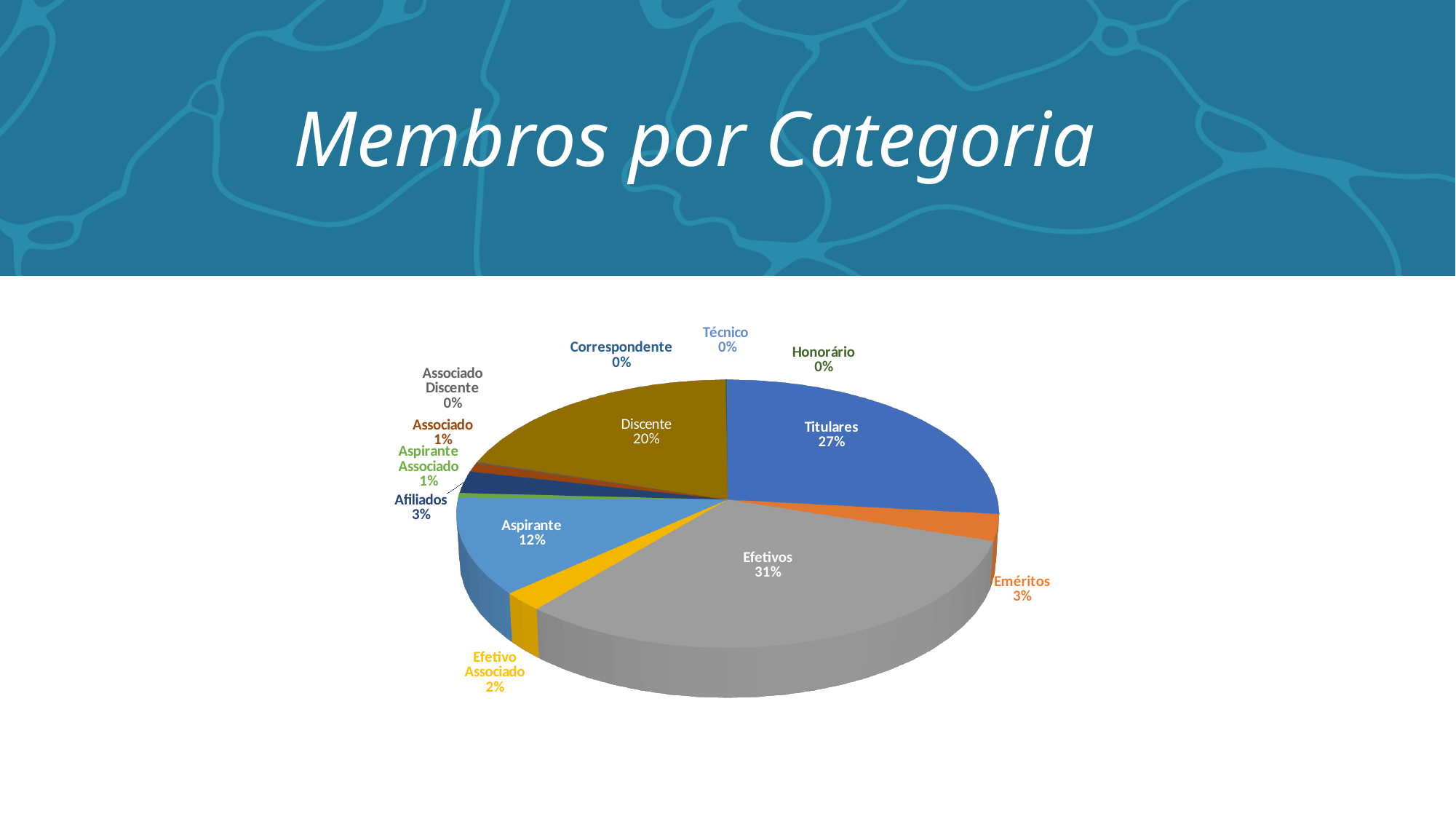
What is the title of the slide? Membros por Categoria What share of members are Eméritos? 3% What share of members are Efetivo Associado? 2% What share of members are Titulares? 27% How many categories are shown in the pie chart? 13 What is the difference in percentage points between Efetivos and Titulares? 4 What share of members are Efetivos? 31% What share of members are Aspirante? 12% Which is larger, the share for Titulares or the share for Discente? Titulares Which category has the largest share of members? Efetivos What kind of chart is shown on the slide? pie chart What share of members are Discente? 20%